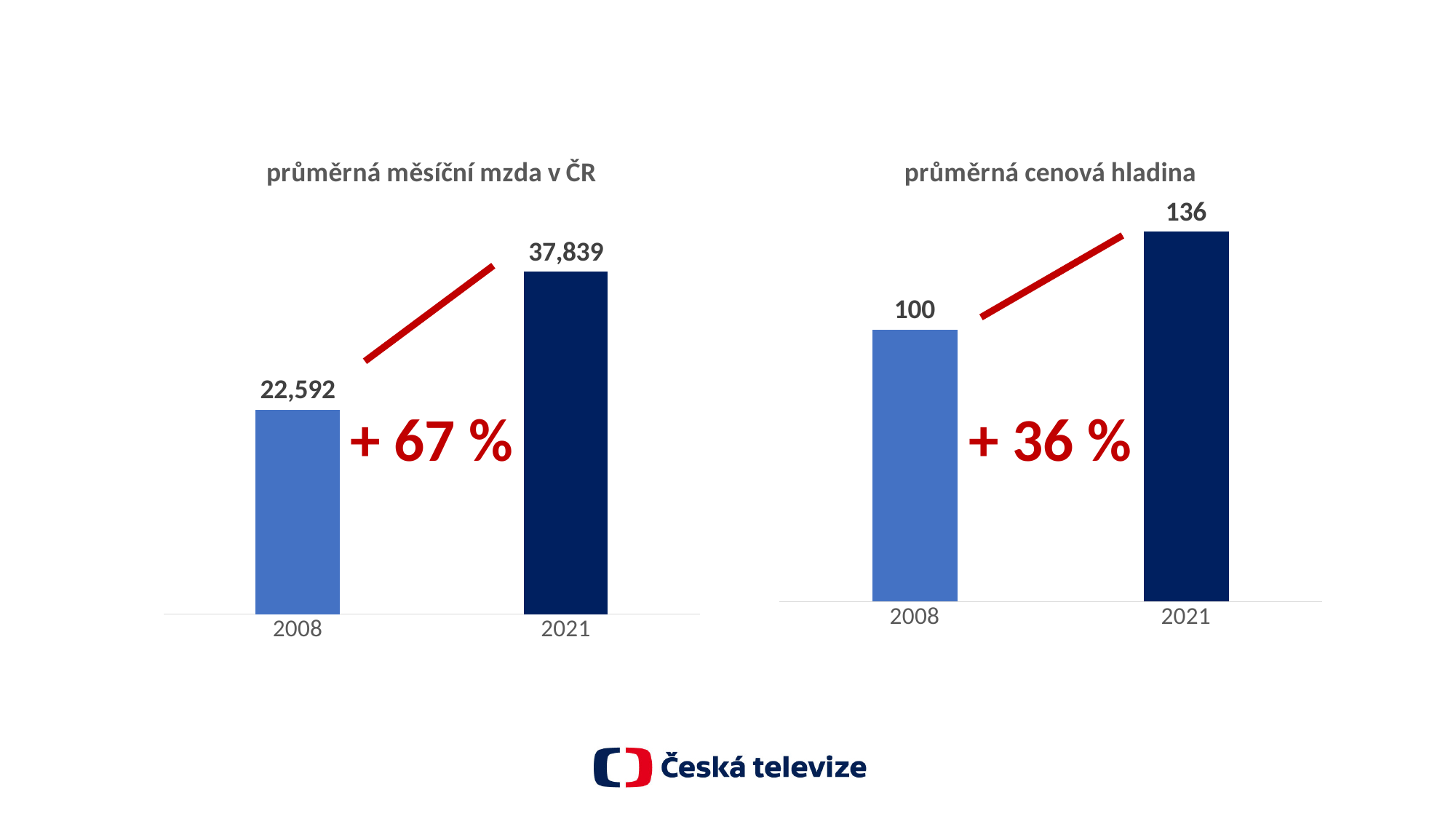
How many bars does the chart titled 'průměrná měsíční mzda v ČR' have? 2 In the chart titled 'průměrná cenová hladina', which year has the lower value? 2008 In the chart titled 'průměrná cenová hladina', what is the value for 2008? 100 In the chart titled 'průměrná cenová hladina', what is the difference between the 2021 and 2008 values? 36 In the chart titled 'průměrná cenová hladina', what is the value for 2021? 136 In the chart titled 'průměrná měsíční mzda v ČR', what is the value for 2021? 37,839 In the chart titled 'průměrná cenová hladina', is the value for 2021 larger or smaller than the value for 2008? larger What percentage increase is annotated in red on the chart titled 'průměrná měsíční mzda v ČR'? + 67 % What kind of chart is the chart titled 'průměrná cenová hladina'? bar chart In the chart titled 'průměrná měsíční mzda v ČR', what is the difference between the 2021 and 2008 values? 15,247 In the chart titled 'průměrná měsíční mzda v ČR', which year has the higher value? 2021 In the chart titled 'průměrná měsíční mzda v ČR', what is the value for 2008? 22,592